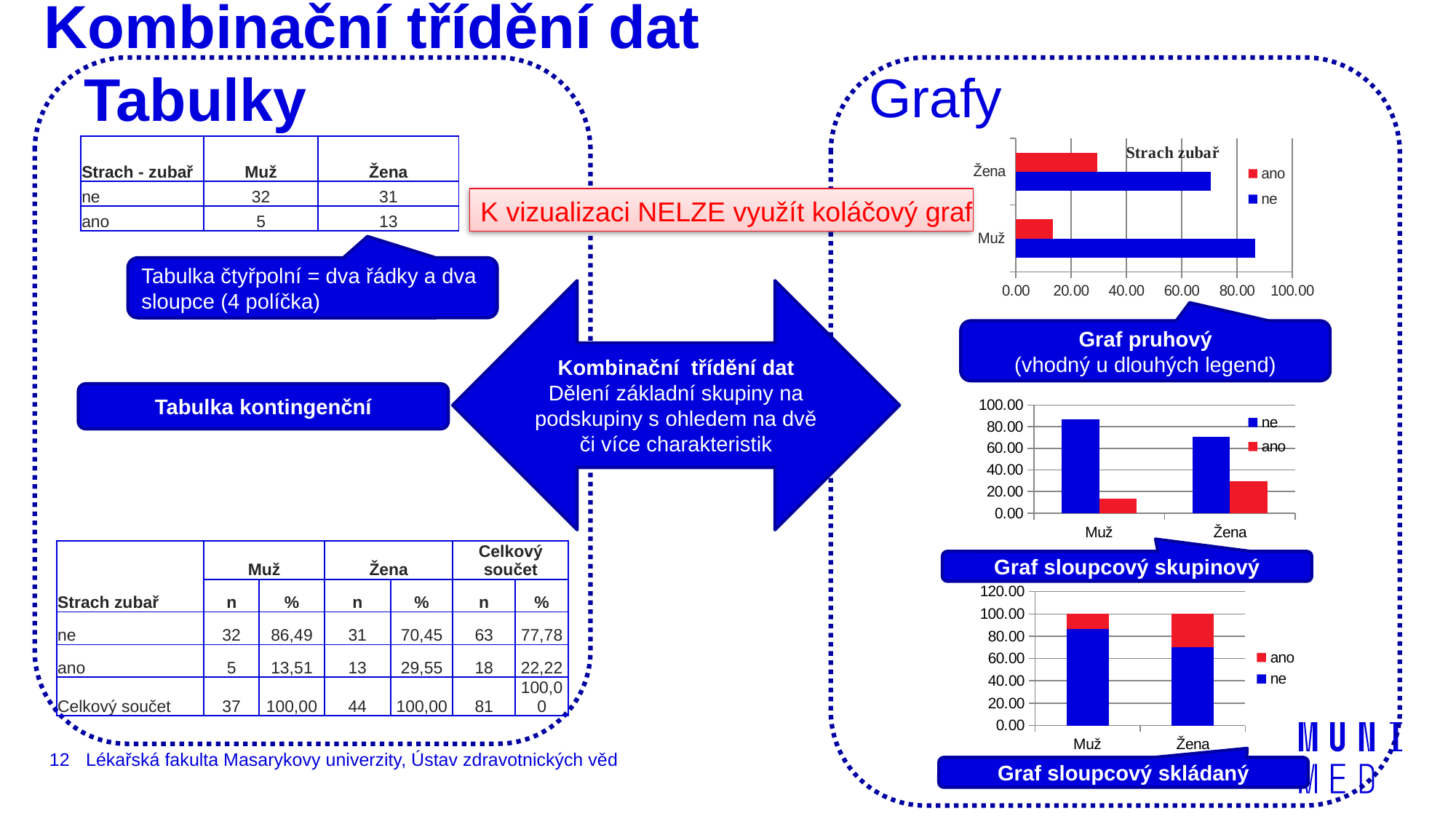
In the 'Strach zubař' chart at the top right, is the 'ne' value for Muž greater or less than 80.00? greater In the 'Strach zubař' chart at the top right, which category has the longer 'ne' bar, Muž or Žena? Muž In the grouped bar chart in the middle right of the slide, how many categories are shown on the x axis? 2 In the 'Strach zubař' chart at the top right, is the 'ano' value for Muž greater or less than 20.00? less In the 'Strach zubař' chart at the top right, how many series does the legend list? 2 In the grouped bar chart in the middle right of the slide, which category has the taller 'ano' bar? Žena In the stacked bar chart at the bottom right of the slide, which category has the larger red 'ano' segment? Žena In the grouped bar chart in the middle right of the slide, is the 'ne' value for Žena greater or less than 60.00? greater What kind of chart is the chart titled 'Strach zubař' at the top right of the slide? bar chart In the grouped bar chart in the middle right of the slide, which series is shown in red? ano In the stacked bar chart at the bottom right of the slide, what is the total height of the Muž bar? 100.00